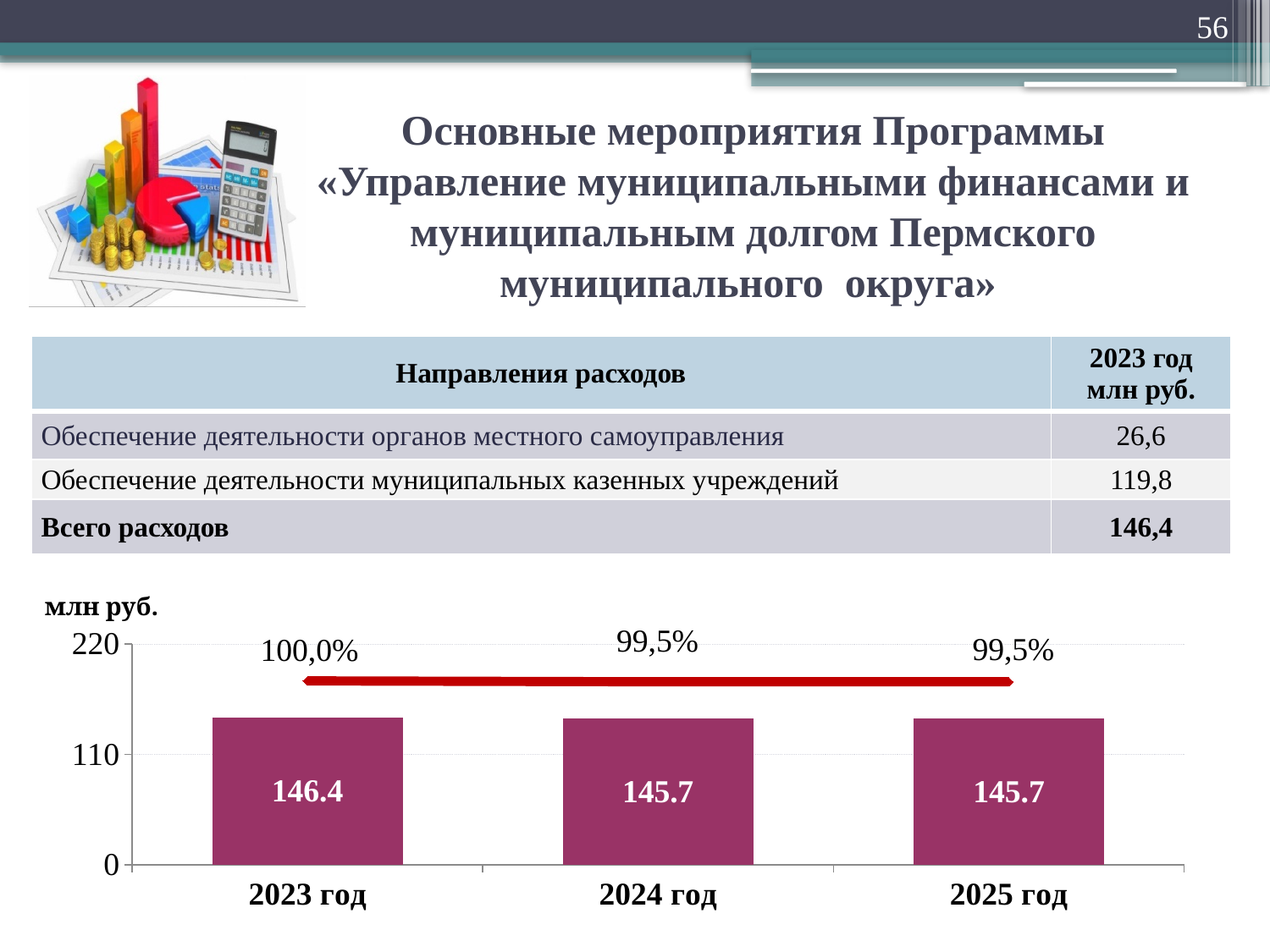
What kind of chart is shown on the slide? combination bar and line chart What is the value for 2024 год in the bar chart? 145.7 Which year has the highest value in the bar chart? 2023 год Is the value for 2023 год in the bar chart greater or less than 220? less Is the value for 2024 год in the bar chart greater or less than 110? greater What percentage label is shown above the 2024 год bar? 99,5% How many bars are shown in the chart? 3 What unit is shown above the vertical axis of the chart? млн руб. Which is larger in the bar chart, the value for 2023 год or the value for 2025 год? 2023 год What is the value for 2023 год in the bar chart? 146.4 What is the value for 2025 год in the bar chart? 145.7 What is the difference between the values for 2023 год and 2024 год in the bar chart? 0.7